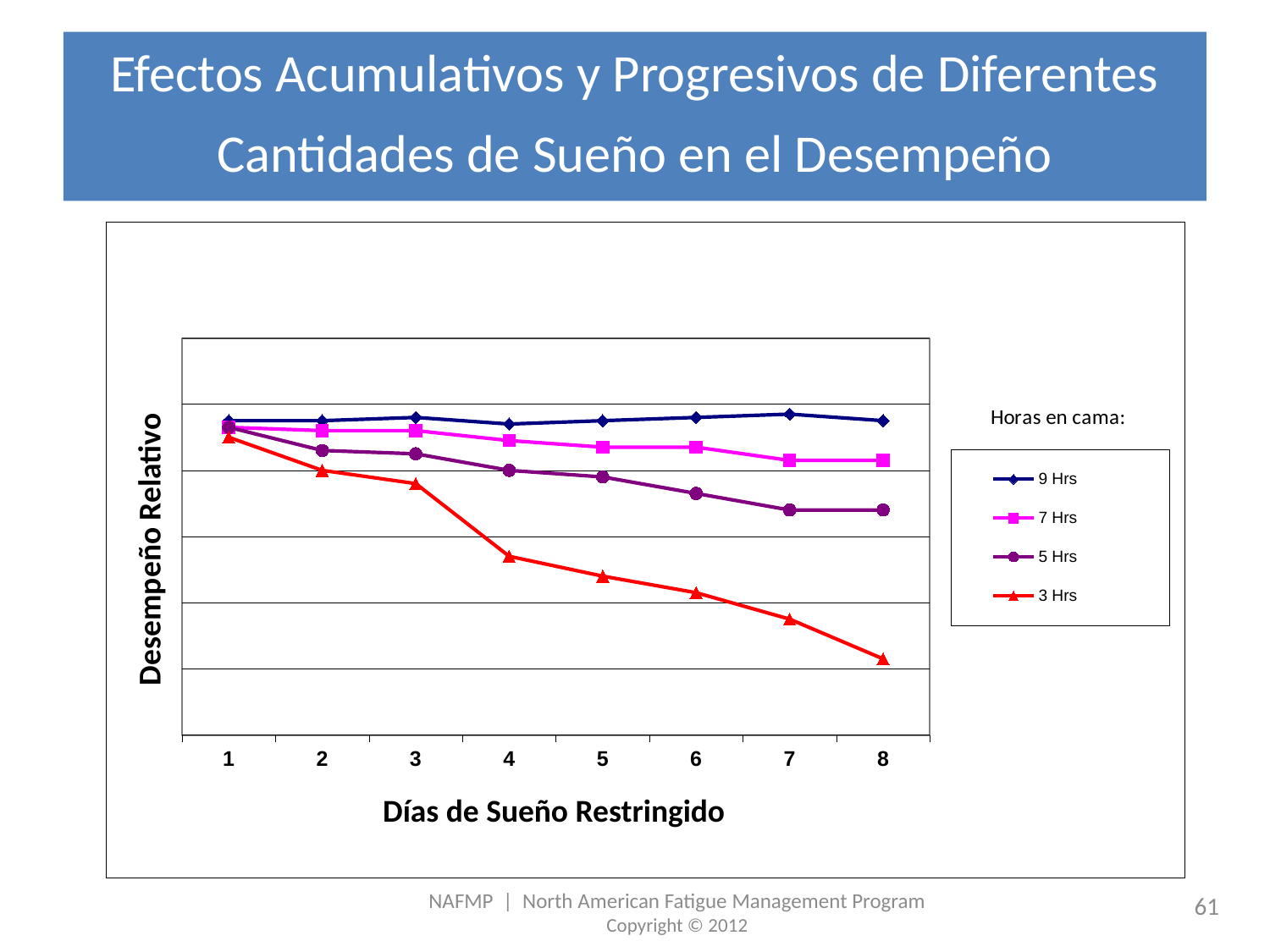
What heading appears above the legend? Horas en cama: Which series has the lowest relative performance on day 8? 3 Hrs How many series does the legend list? 4 How many days are shown along the x axis? 8 Which series has the highest relative performance on day 8? 9 Hrs On day 8, which series is higher: 7 Hrs or 5 Hrs? 7 Hrs What kind of chart is shown on the slide? line chart Does the 3 Hrs series rise or fall as the days of restricted sleep increase? fall On day 4, which series is higher: 5 Hrs or 3 Hrs? 5 Hrs Which series stays roughly flat across the 8 days? 9 Hrs What is the title of the x axis? Días de Sueño Restringido